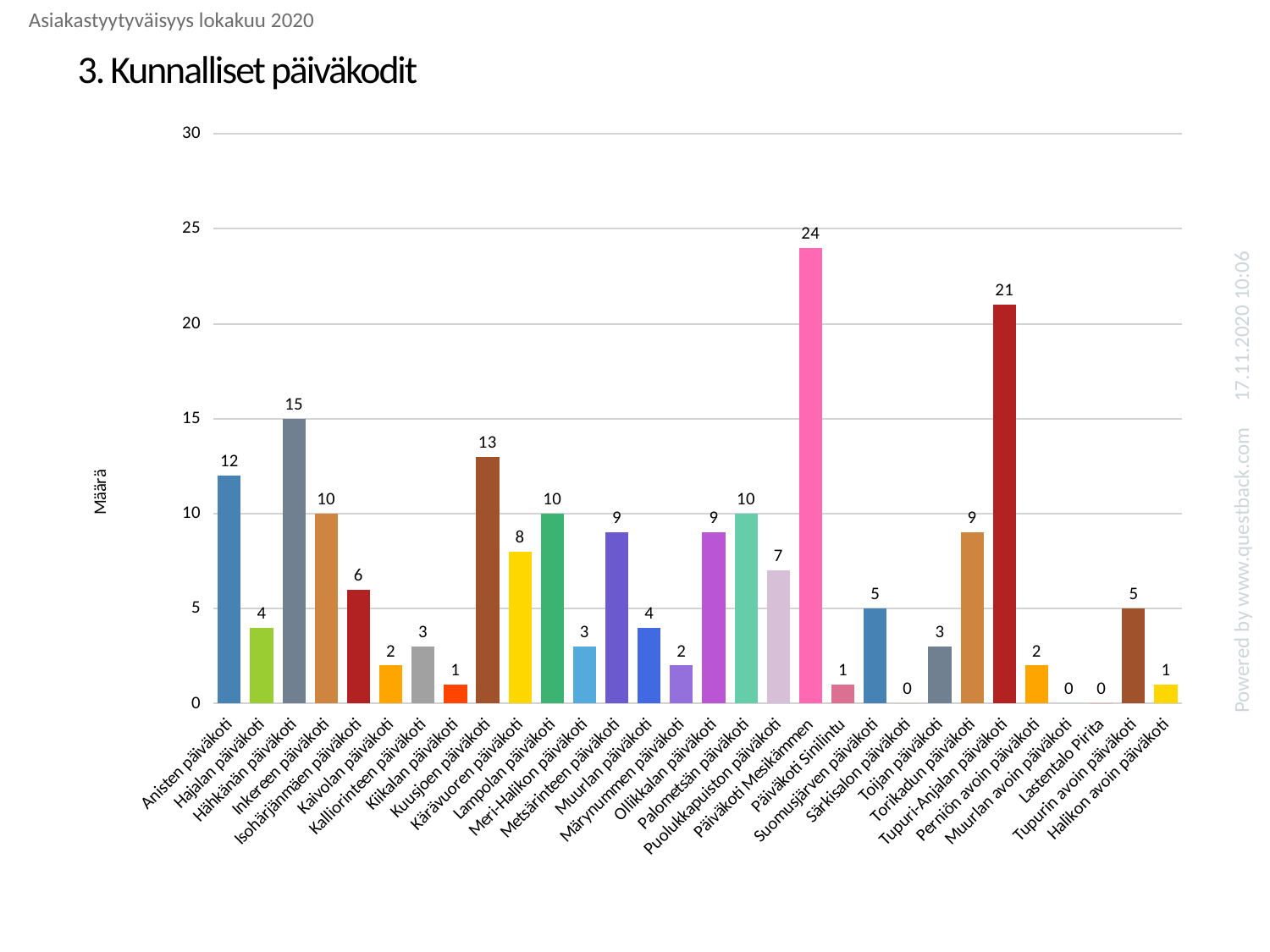
What is the value for Puolukkapuiston päiväkoti? 7 Which category has the highest value? Päiväkoti Mesikämmen Is the value for Hähkänän päiväkoti greater or less than 10? greater What is the label of the y axis? Määrä What is the difference between the values for Päiväkoti Mesikämmen and Tupuri-Anjalan päiväkoti? 3 What kind of chart is shown on the slide? bar chart What is the difference between the values for Hähkänän päiväkoti and Anisten päiväkoti? 3 How many categories are shown on the x axis? 30 What is the value for Tupuri-Anjalan päiväkoti? 21 What is the value for Kuusjoen päiväkoti? 13 Which is larger, the value for Kuusjoen päiväkoti or the value for Kärävuoren päiväkoti? Kuusjoen päiväkoti What is the value for Päiväkoti Mesikämmen? 24